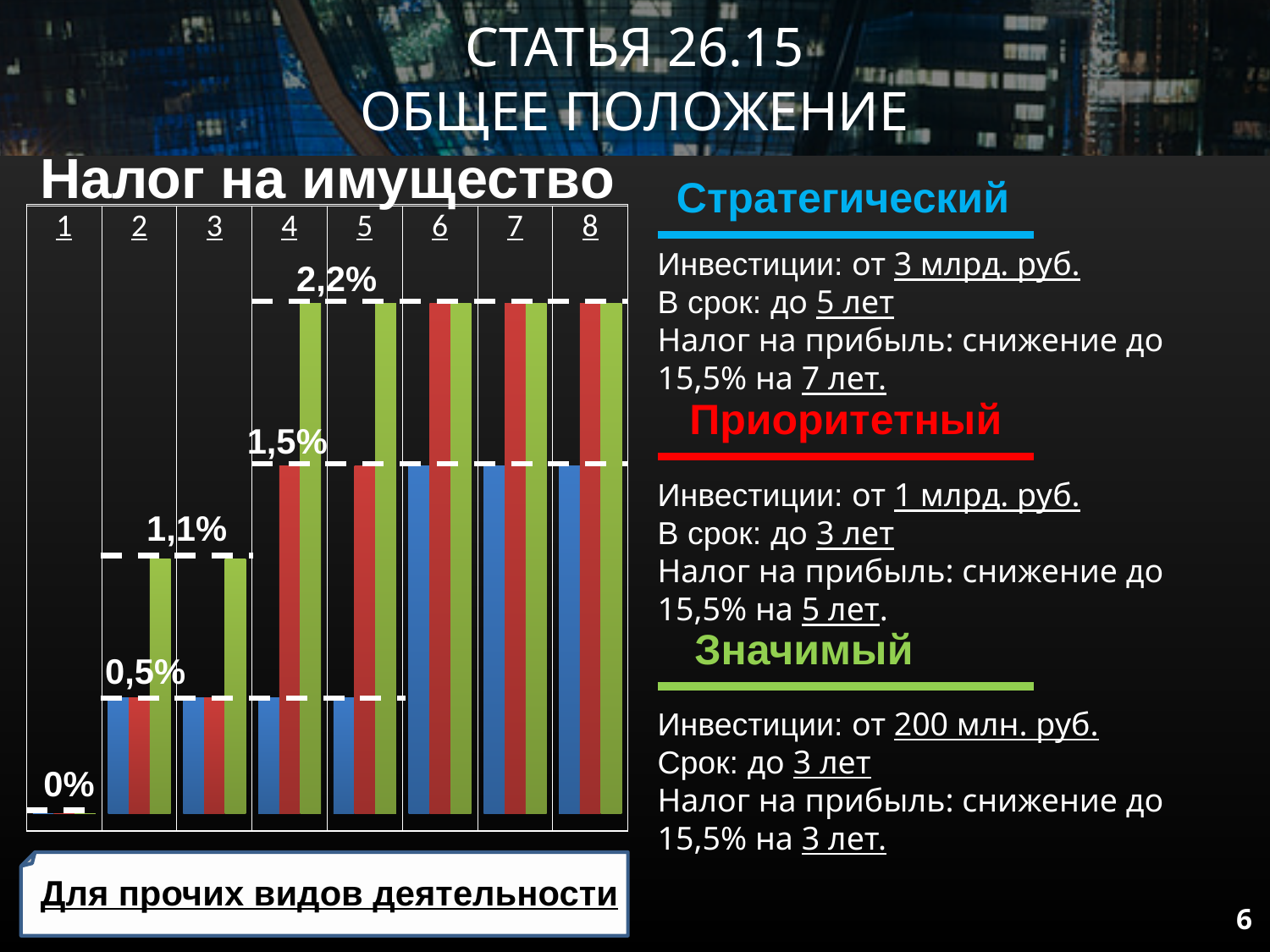
How many series (bar colours) are plotted for each category in the chart? 3 What is the value of the green bar in category 2? 1,1% What is the difference between the green bar and the blue bar in category 4? 1,7% What is the value shown for category 1? 0% What kind of chart is shown under the title "Налог на имущество"? bar chart In category 2, which is larger: the green bar or the blue bar? green bar What is the title of the chart? Налог на имущество What is the value of the red bar in category 4? 1,5% Which bar colour has the highest value in category 4? green How many categories (numbered periods) are shown along the x axis of the chart? 8 What is the value of the blue bar in category 6? 1,5% What is the value of the green bar in category 4? 2,2%